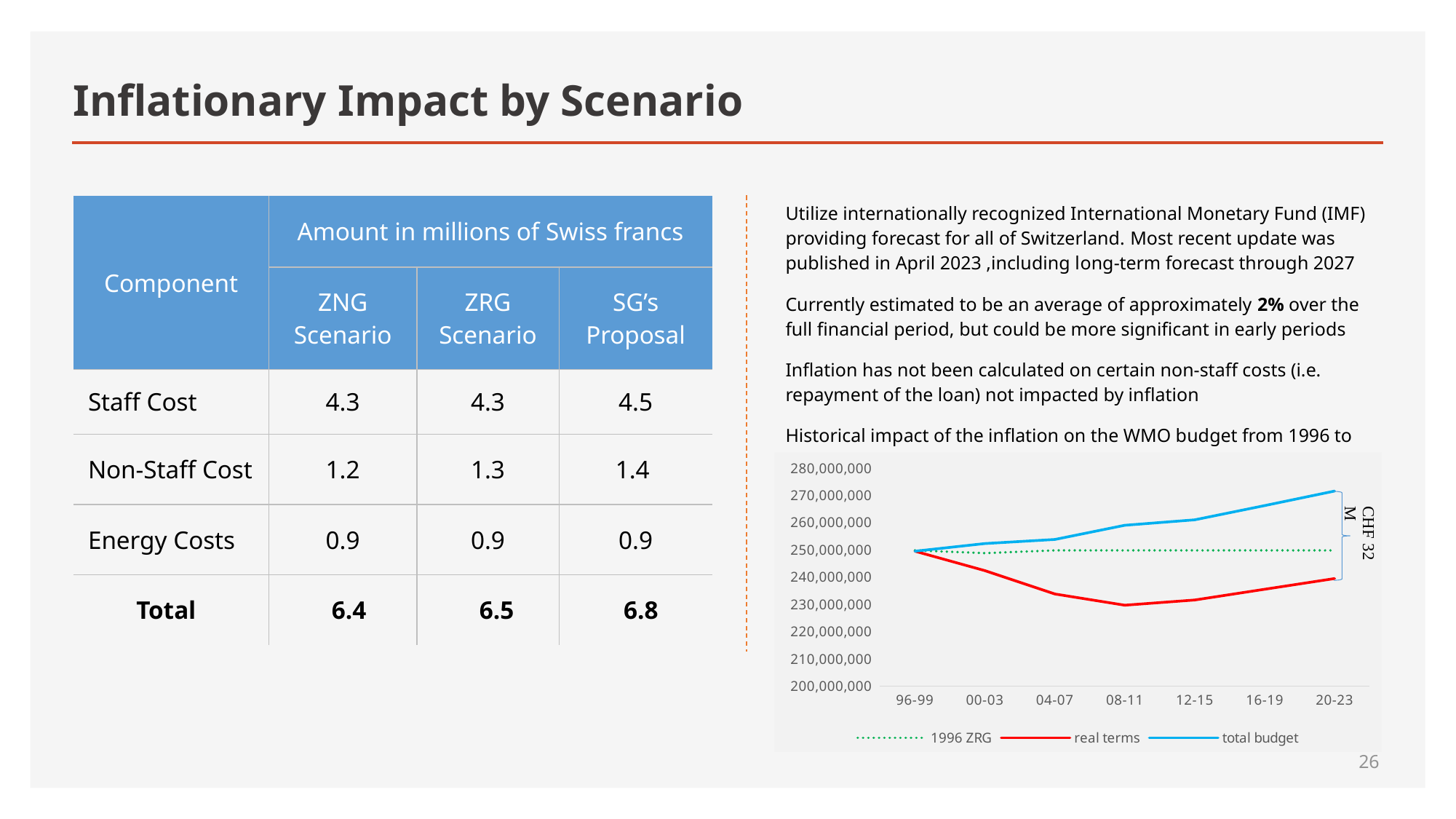
How many series does the legend of the line chart list? 3 In the line chart, is the real terms value for 08-11 greater or less than 240,000,000? less In the line chart, what is the first period shown on the x axis? 96-99 In the line chart, which series is higher at 20-23: total budget or real terms? total budget In the line chart, at which period is the real terms series lowest? 08-11 In the line chart, at which period is the total budget series highest? 20-23 What kind of chart is shown on the right side of the slide? line chart In the line chart, does the real terms series rise or fall from 96-99 to 08-11? fall In the line chart, is the total budget value for 20-23 greater or less than 260,000,000? greater How many periods are shown on the x axis of the line chart? 7 In the line chart, does the total budget series rise or fall from 96-99 to 20-23? rise What gap is annotated at the right end of the line chart between the total budget and real terms lines? CHF 32 M